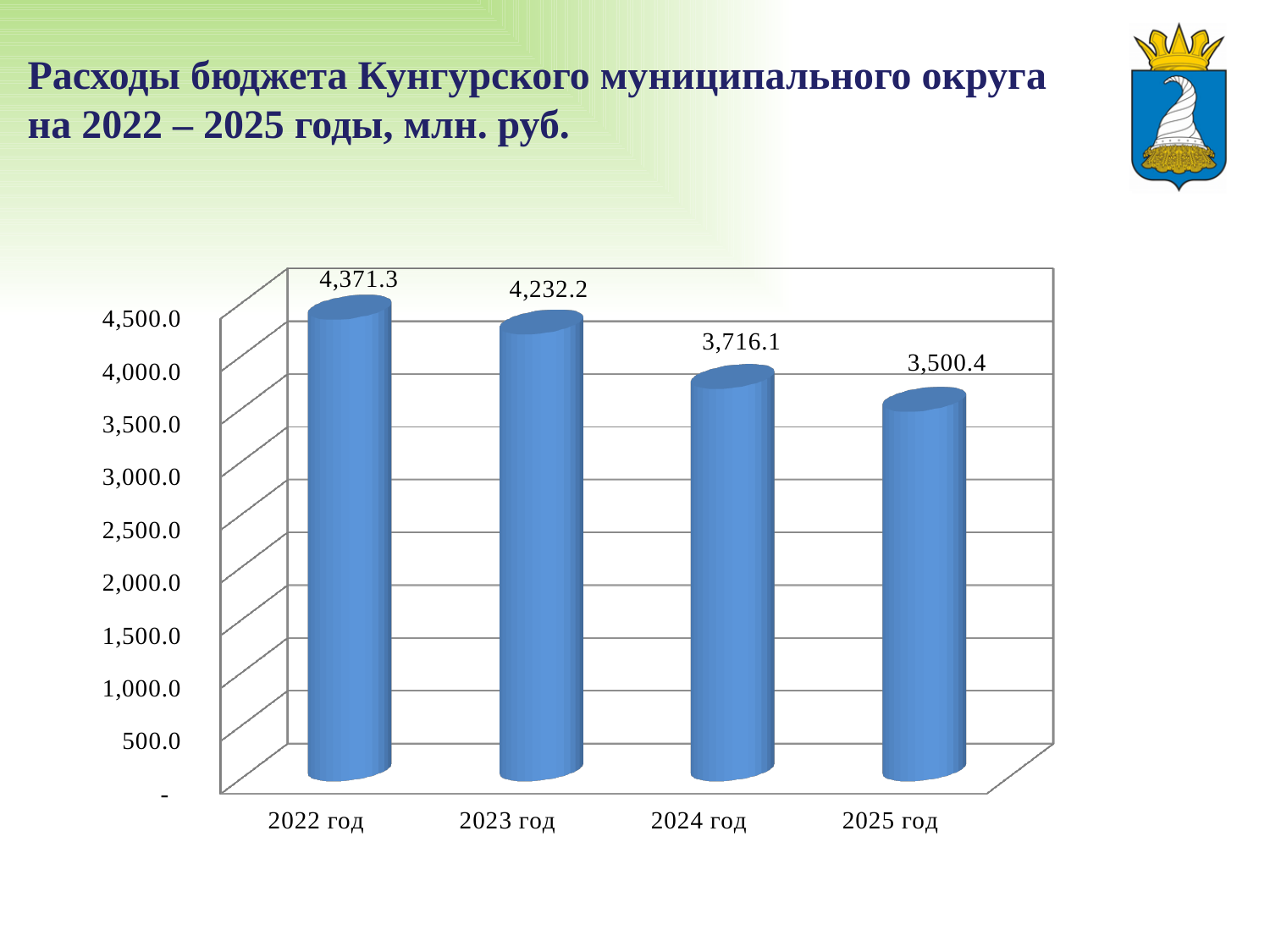
What is the difference between the values for 2022 год and 2025 год? 870.9 Do the values rise or fall from 2022 год to 2025 год? fall What is the difference between the values for 2023 год and 2024 год? 516.1 What is the value for 2024 год? 3,716.1 Which year has the lowest value? 2025 год What is the value for 2022 год? 4,371.3 What is the value for 2023 год? 4,232.2 How many years are shown on the x axis? 4 What is the value for 2025 год? 3,500.4 Is the value for 2024 год greater or less than 4,000.0? less Which year has the highest value? 2022 год Which is larger, the value for 2023 год or the value for 2024 год? 2023 год